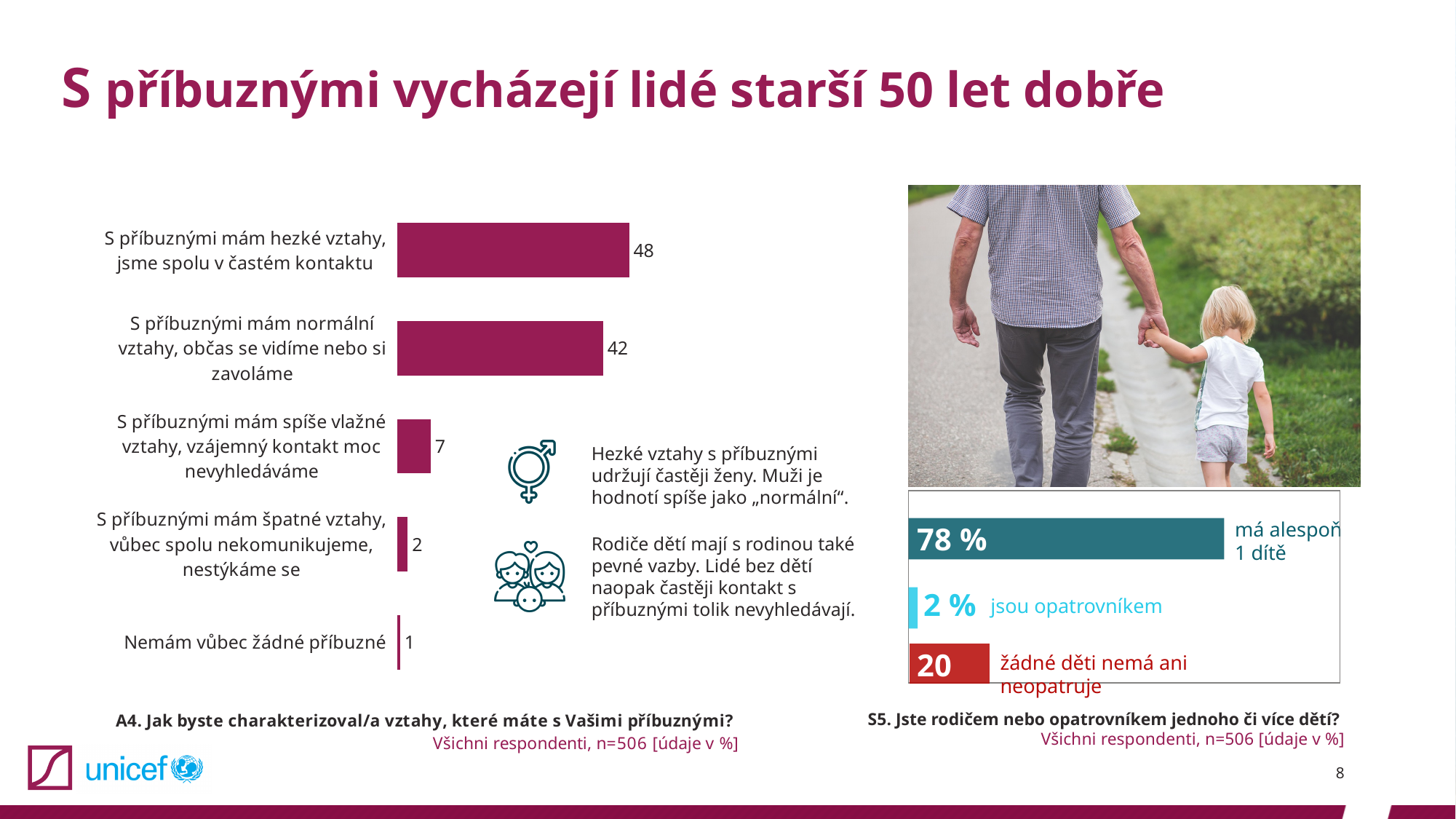
How many categories does the left chart (A4) show? 5 In the right chart (S5, parents or guardians of children), what is the value for "má alespoň 1 dítě"? 78 % In the left chart (A4, relationships with relatives), what is the value for "S příbuznými mám hezké vztahy, jsme spolu v častém kontaktu"? 48 What type of chart is the left chart (A4)? bar chart In the right chart (S5), what is the value for "žádné děti nemá ani neopatruje"? 20 In the left chart (A4), which category has the highest value? S příbuznými mám hezké vztahy, jsme spolu v častém kontaktu In the right chart (S5), what is the value for "jsou opatrovníkem"? 2 % In the left chart (A4), what is the difference between the values for "hezké vztahy" and "normální vztahy"? 6 In the left chart (A4), which is larger: the value for "spíše vlažné vztahy" or for "špatné vztahy"? spíše vlažné vztahy In the left chart (A4), which category has the lowest value? Nemám vůbec žádné příbuzné In the left chart (A4), what is the value for "Nemám vůbec žádné příbuzné"? 1 In the left chart (A4), what is the value for "S příbuznými mám normální vztahy, občas se vidíme nebo si zavoláme"? 42